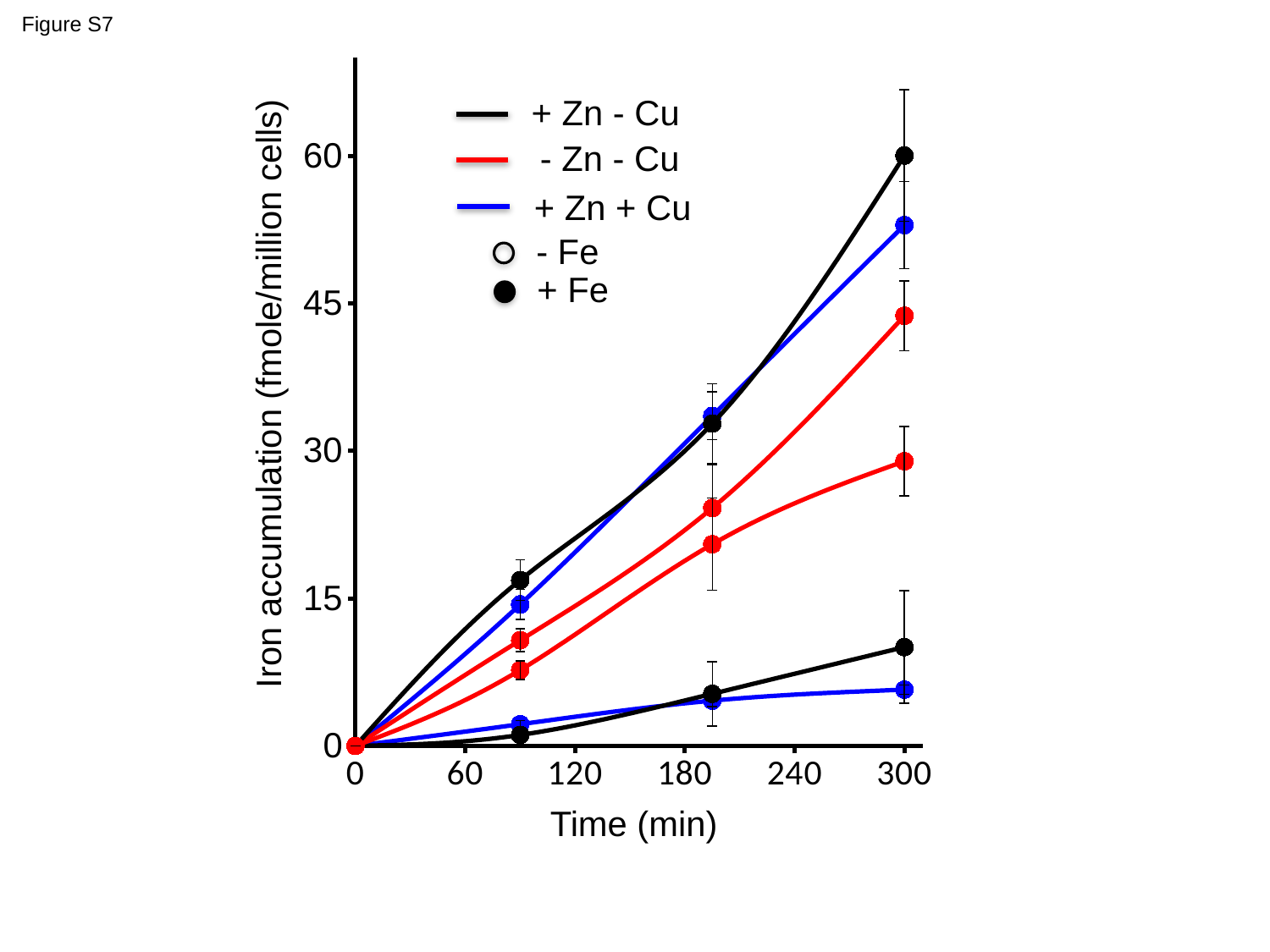
Is the highest black line value at 300 min greater or less than 45? greater How many coloured line conditions does the legend list? 3 What kind of chart is shown on the slide? line chart At 300 min, is the upper black line value larger or smaller than the upper red line value? larger Is the lowest black line value at 300 min greater or less than 15? less How many tick labels are shown on the x axis? 6 What is the label of the x axis? Time (min) What is the label of the y axis? Iron accumulation (fmole/million cells) Which colour line reaches the highest value at 300 min? black Is the highest blue line value at 300 min greater or less than 45? greater Do the plotted lines rise or fall as time increases? rise Which colour line has the lowest value at 300 min? blue